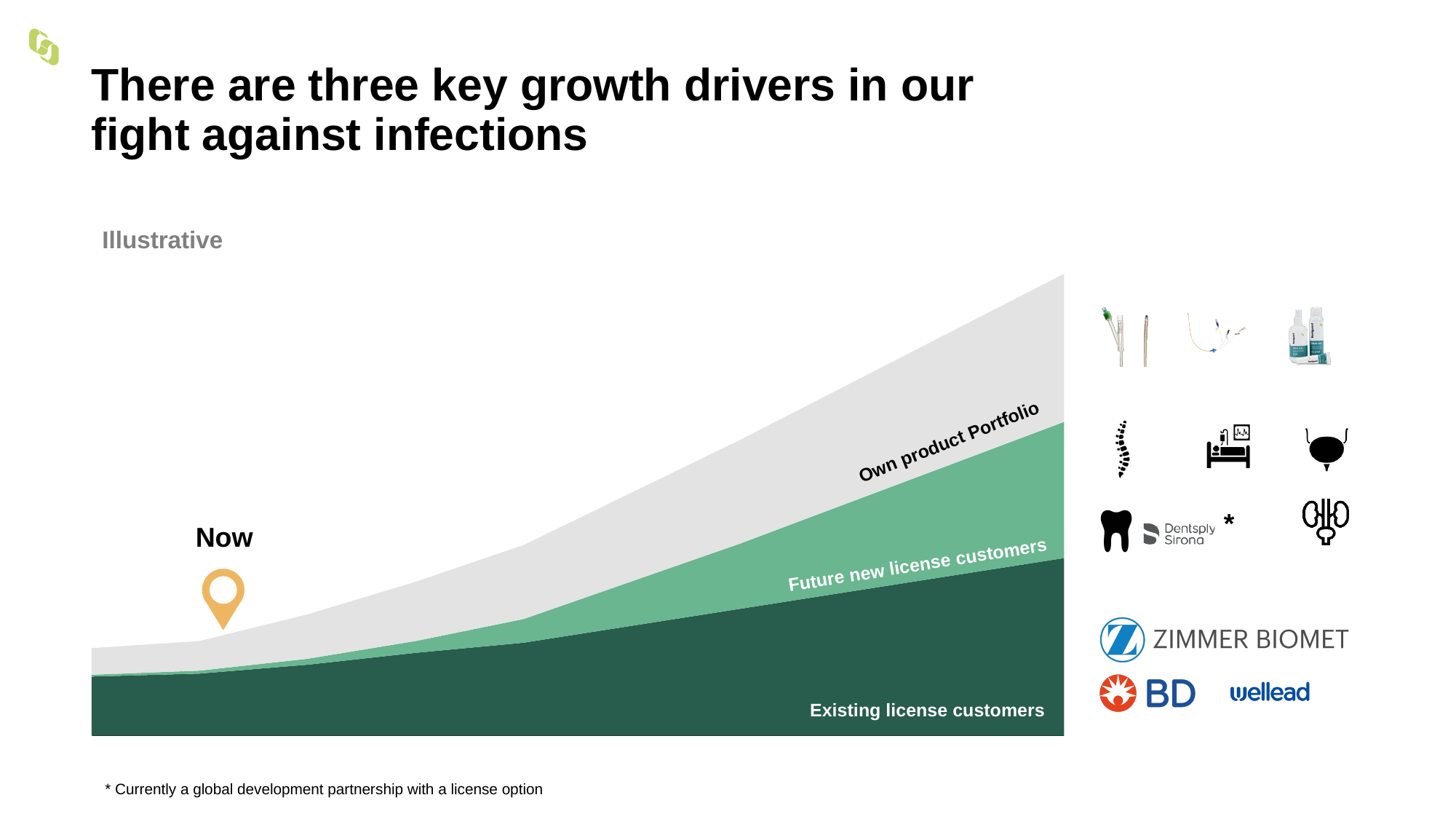
What label is shown above the orange location marker on the chart? Now Which series is labelled in the middle layer of the chart? Future new license customers At the point marked 'Now', which of the three areas is the smallest? Future new license customers How many series (areas) are labelled in the chart? 3 Which series forms the bottom layer of the stacked area chart? Existing license customers What kind of chart is shown on the slide? Stacked area chart Do the values in the chart rise or fall from left to right? Rise What word appears above the chart to indicate the nature of the data? Illustrative At the point marked 'Now', which of the three areas is the largest? Existing license customers Which series forms the top layer of the stacked area chart? Own product Portfolio